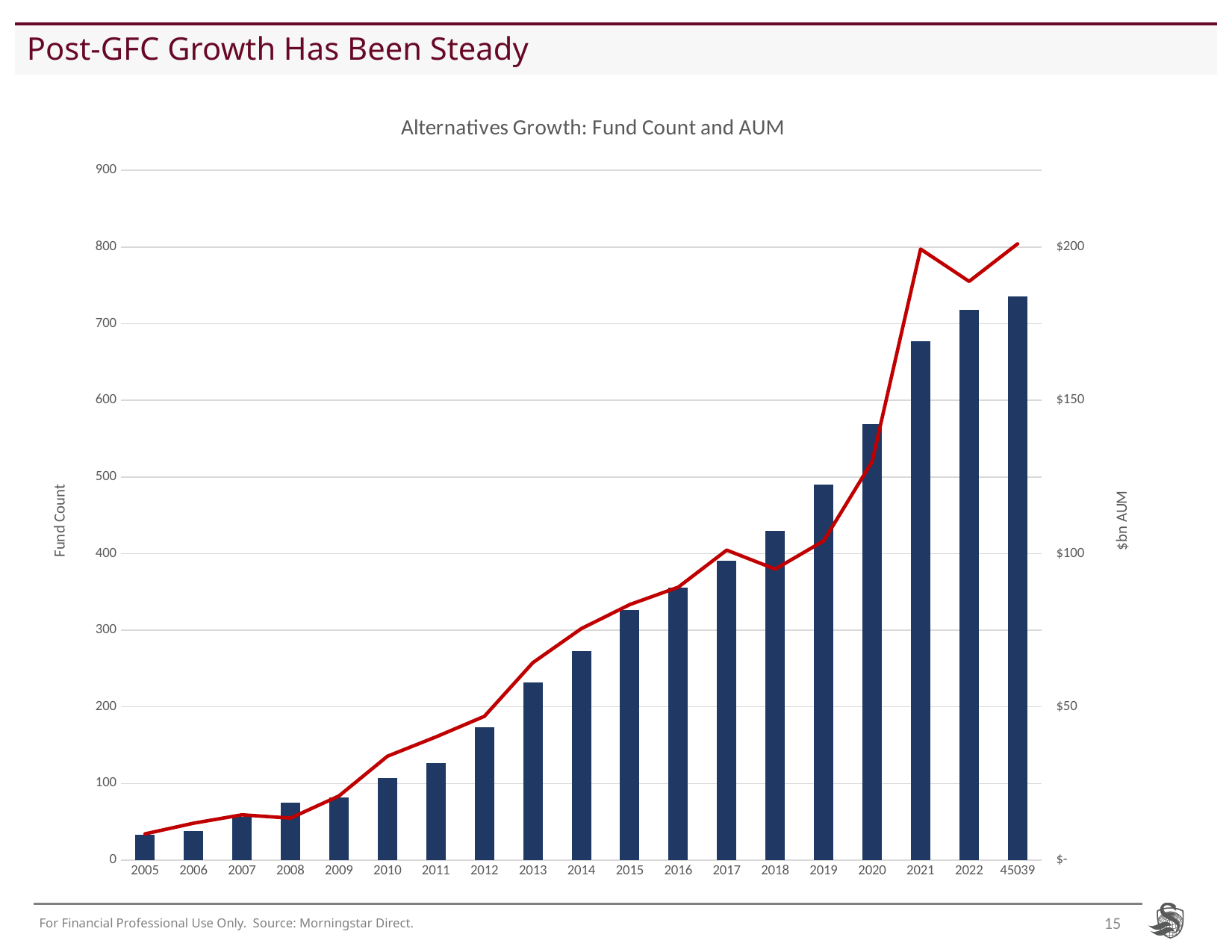
What kind of chart is shown on the slide? A combination bar and line chart What is the title of the chart? Alternatives Growth: Fund Count and AUM Which year has the shortest bar for fund count? 2005 Is the AUM line value for 2022 greater or less than $200? less Is the fund count bar for 2020 greater or less than 500? greater What is the label of the right-hand vertical axis? $bn AUM Is the fund count bar for 2015 greater or less than 300? greater Which category has the tallest bar for fund count? 45039 Which year has the higher fund count bar, 2019 or 2020? 2020 How many categories are shown along the x axis? 19